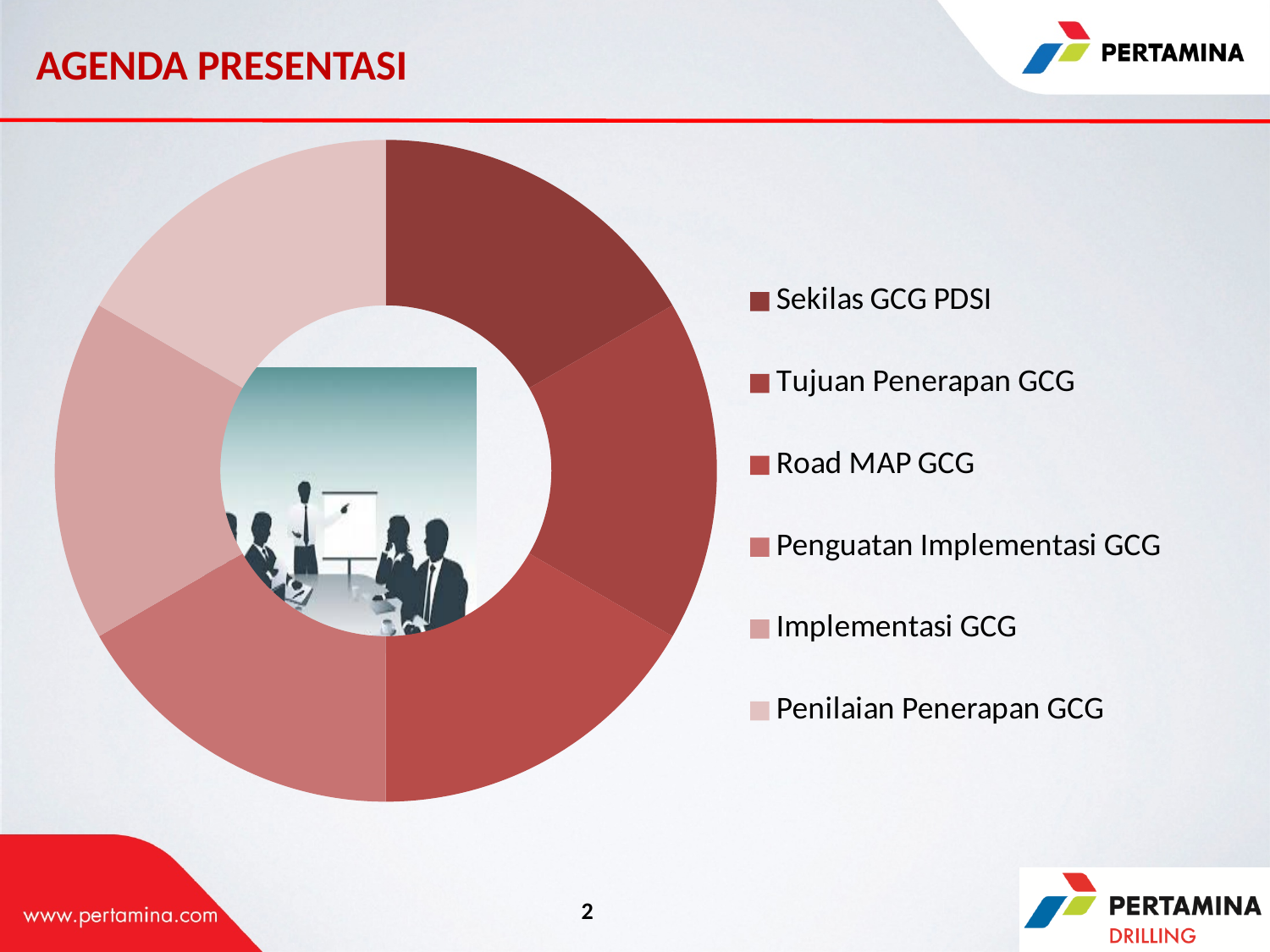
Are the segments of the doughnut chart all the same size? yes What kind of chart is shown on the slide? doughnut chart What is the first entry listed in the chart's legend? Sekilas GCG PDSI How many entries does the legend of the chart list? 6 How many segments does the doughnut chart have? 6 Which legend entry is shown with the lightest shade in the chart? Penilaian Penerapan GCG